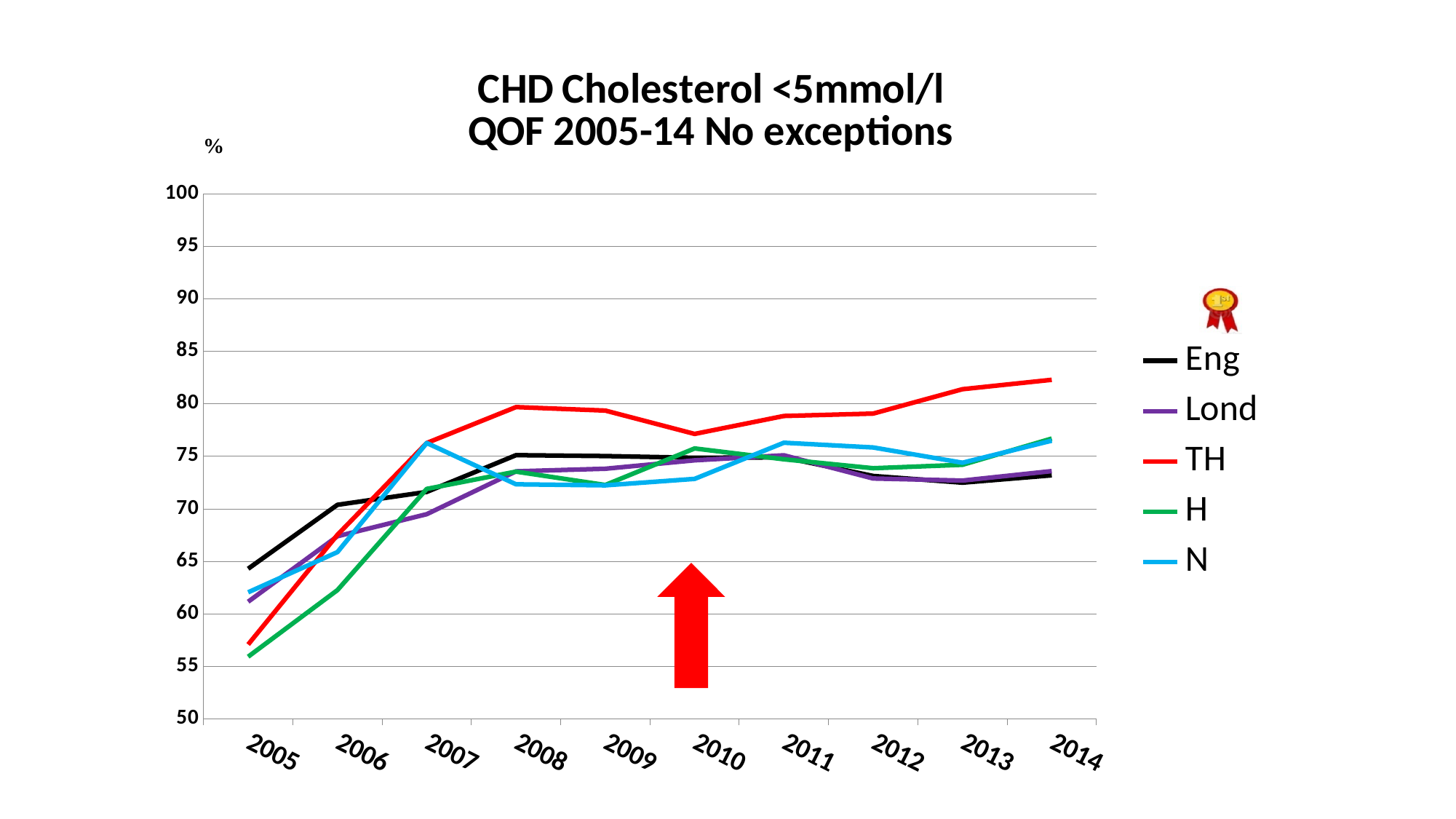
What colour is the TH line in the legend? red Is the value for TH in 2014 greater or less than 80? greater What kind of chart is shown on the slide? line chart Does the TH series rise or fall from 2005 to 2014? rise How many series does the legend list? 5 Which series has the highest value in 2005? Eng Is the value for H in 2005 greater or less than 60? less Which series has the highest value in 2014? TH Is the value for Eng in 2014 greater or less than 75? less In 2014, which is larger, the value for TH or the value for Eng? TH How many years are shown along the x axis? 10